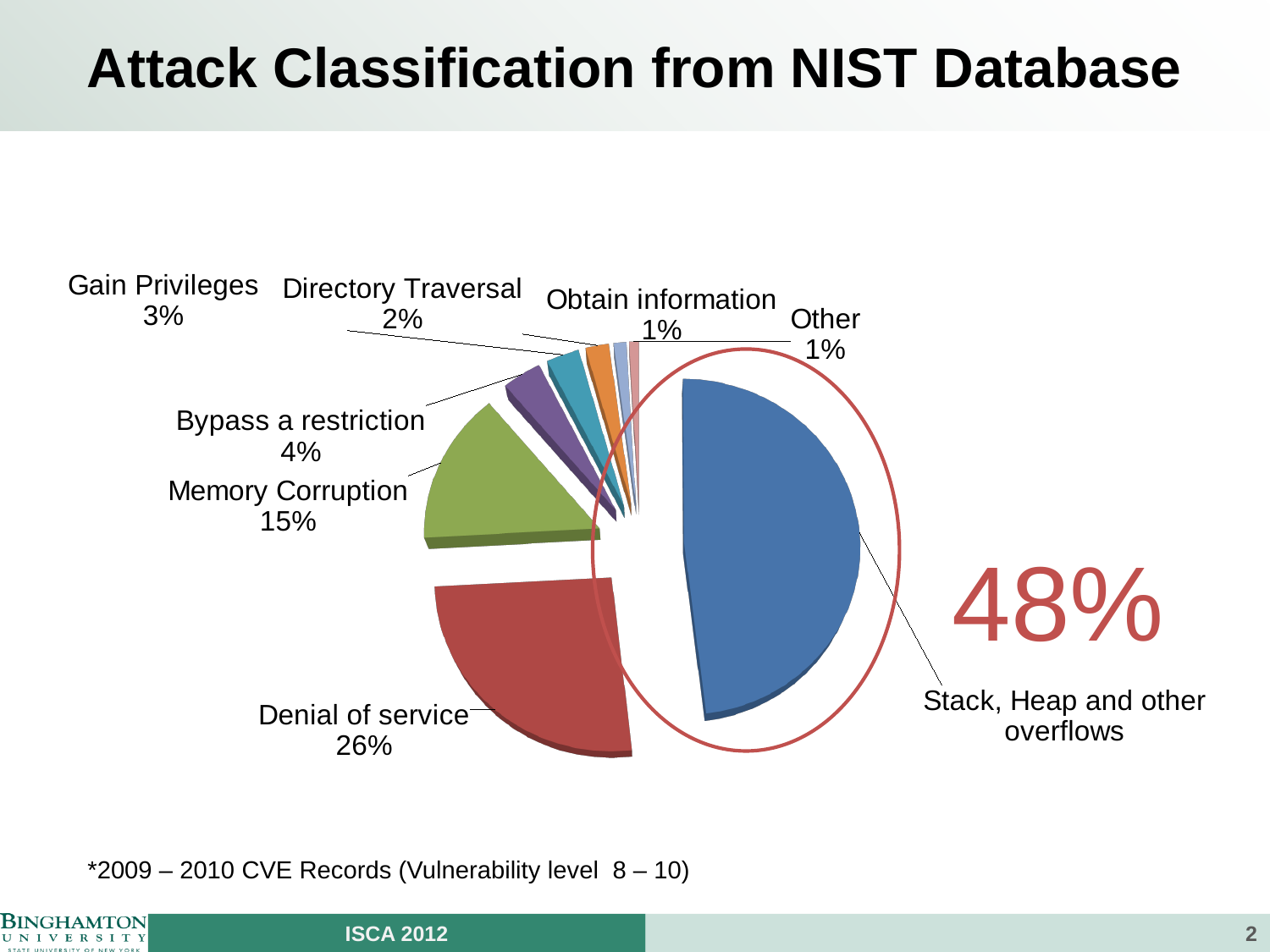
What percentage is shown for Bypass a restriction? 4% What percentage is shown for Memory Corruption? 15% What percentage is shown for Directory Traversal? 2% How many categories are shown in the pie chart? 8 Which category has the largest slice of the pie? Stack, Heap and other overflows What share of the pie is labelled for Denial of service? 26% What kind of chart is shown on the slide? Pie chart What percentage is shown for Gain Privileges? 3% Which is larger, the share for Memory Corruption or the share for Bypass a restriction? Memory Corruption What is the title of the slide containing the chart? Attack Classification from NIST Database What colour is the slice for Stack, Heap and other overflows? Blue What is the difference in percentage points between Denial of service and Memory Corruption? 11